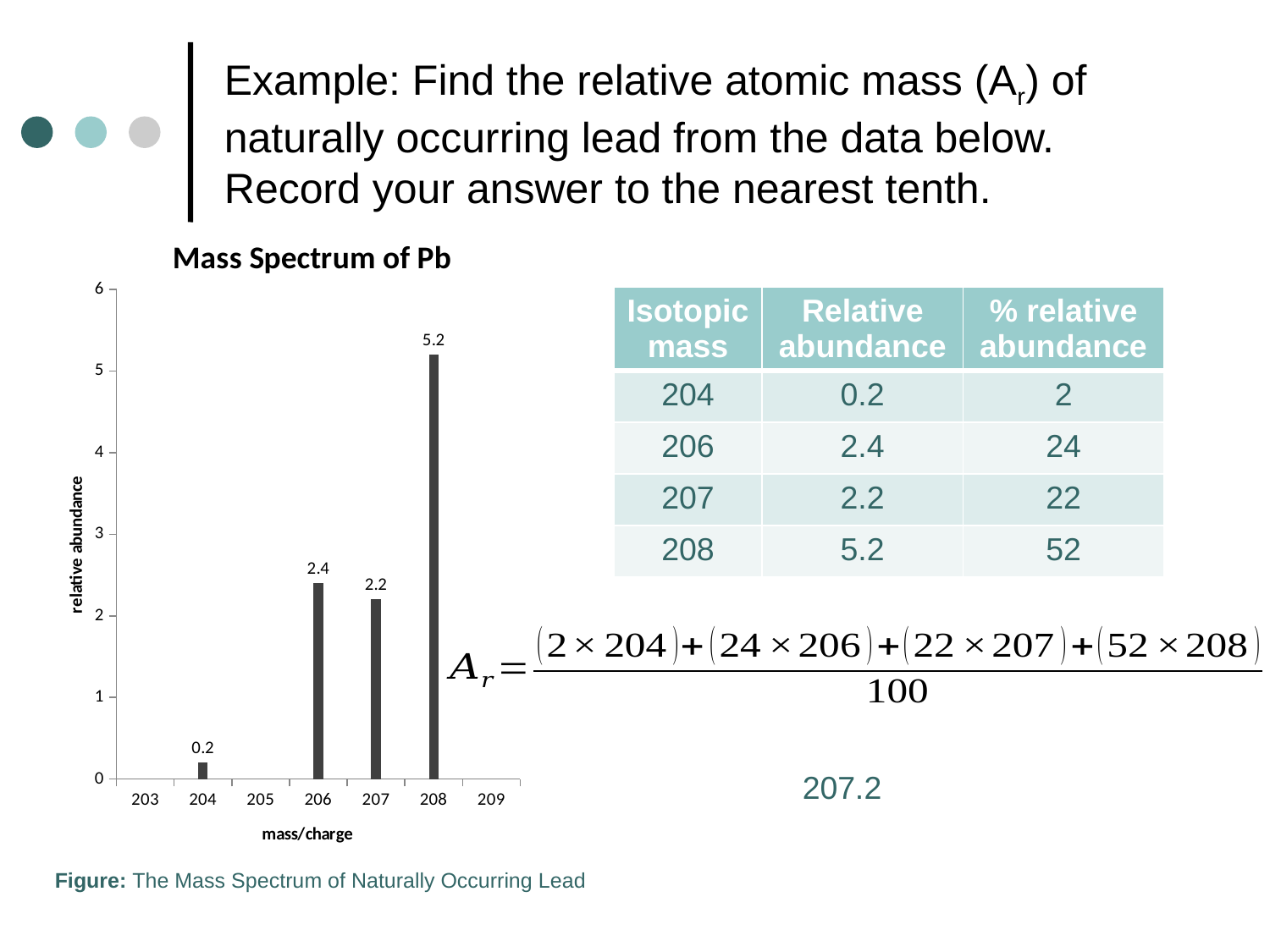
In the Mass Spectrum of Pb chart, which has a larger relative abundance: mass/charge 206 or mass/charge 207? 206 Which mass/charge value has the highest relative abundance in the Mass Spectrum of Pb chart? 208 What kind of chart is the Mass Spectrum of Pb? bar chart What is the title of the chart on the slide? Mass Spectrum of Pb How many bars with data labels are plotted in the Mass Spectrum of Pb chart? 4 What is the difference in relative abundance between mass/charge 208 and mass/charge 206 in the Mass Spectrum of Pb chart? 2.8 Which mass/charge value has the lowest relative abundance in the Mass Spectrum of Pb chart? 204 What is the relative abundance at mass/charge 204 in the Mass Spectrum of Pb chart? 0.2 What is the relative abundance at mass/charge 207 in the Mass Spectrum of Pb chart? 2.2 What is the relative abundance at mass/charge 208 in the Mass Spectrum of Pb chart? 5.2 Is the relative abundance at mass/charge 208 in the Mass Spectrum of Pb chart greater or less than 5? greater What is the relative abundance at mass/charge 206 in the Mass Spectrum of Pb chart? 2.4